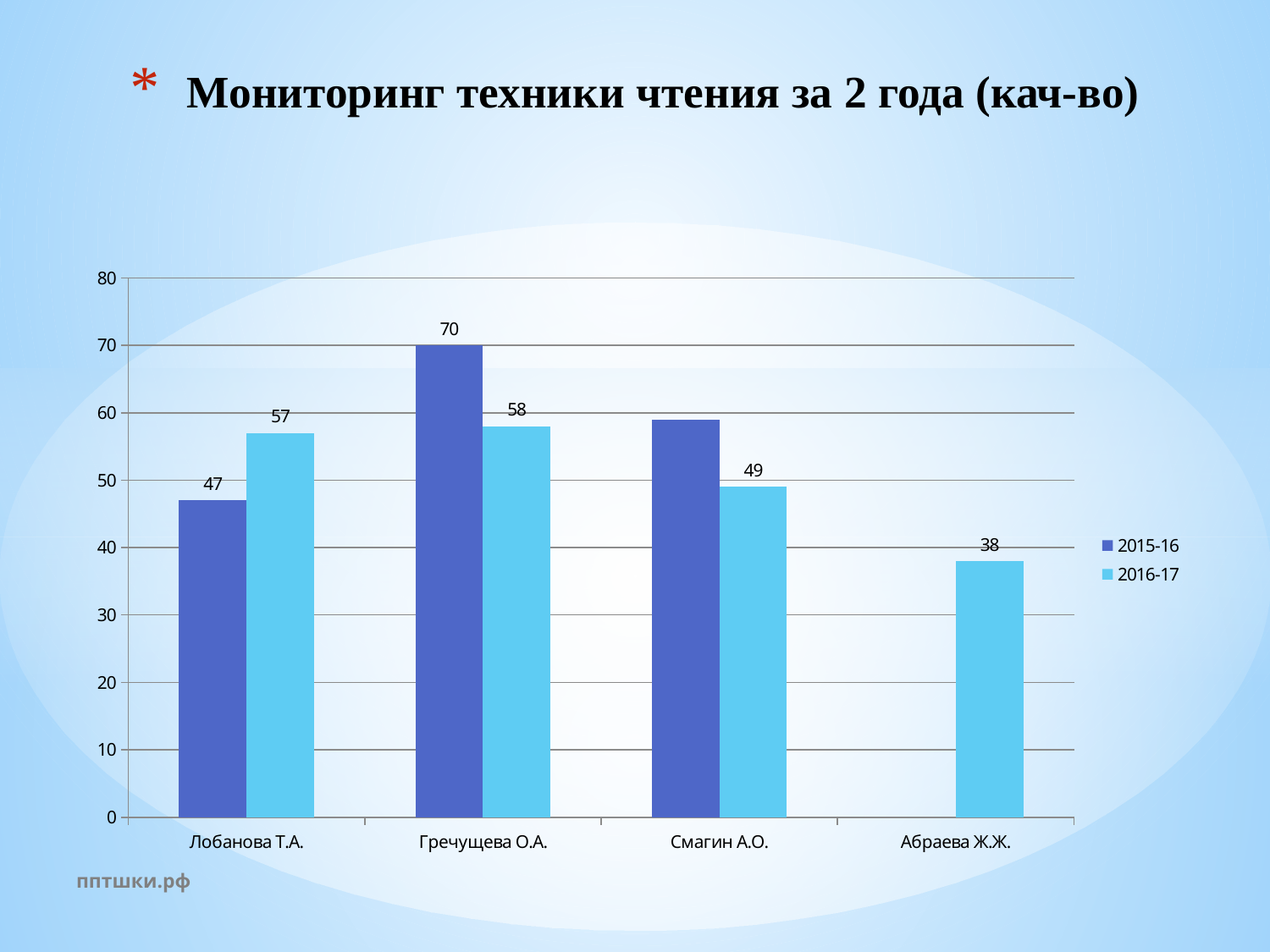
What kind of chart is shown on the slide? bar chart Which category has the lowest value in the 2016-17 series? Абраева Ж.Ж. Is the 2015-16 value for Смагин А.О. greater or less than 50? greater What is the difference between the 2015-16 and 2016-17 values for Гречущева О.А.? 12 How many series does the legend list? 2 What is the value for Лобанова Т.А. in the 2015-16 series? 47 How many categories are shown on the x axis? 4 Which category has the highest value in the 2016-17 series? Гречущева О.А. What is the value for Абраева Ж.Ж. in the 2016-17 series? 38 What is the difference between the 2016-17 and 2015-16 values for Лобанова Т.А.? 10 For Лобанова Т.А., which series has the larger value, 2015-16 or 2016-17? 2016-17 What is the value for Гречущева О.А. in the 2016-17 series? 58